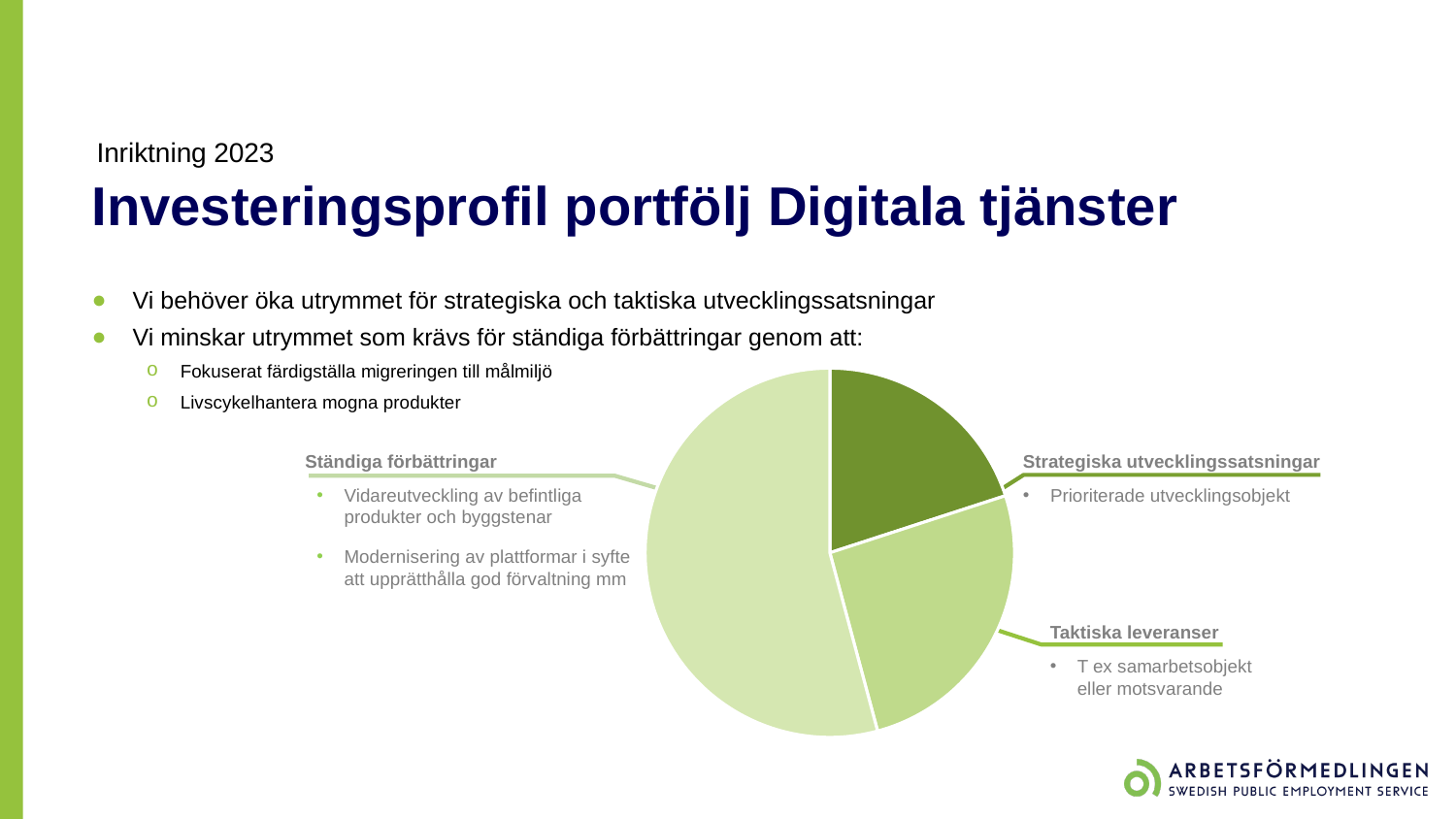
Which slice of the pie chart is drawn in the lightest green? Ständiga förbättringar What kind of chart is shown on the slide? pie chart Which slice of the pie chart is the largest? Ständiga förbättringar How many slices does the pie chart have? 3 What are the three categories labelled around the pie chart? Ständiga förbättringar, Strategiska utvecklingssatsningar, Taktiska leveranser Which slice of the pie chart is the smallest? Strategiska utvecklingssatsningar Does the Ständiga förbättringar slice take up more or less than half of the pie? more Which slice is larger: Ständiga förbättringar or Taktiska leveranser? Ständiga förbättringar Which slice is larger: Taktiska leveranser or Strategiska utvecklingssatsningar? Taktiska leveranser Which slice of the pie chart is drawn in the darkest green? Strategiska utvecklingssatsningar